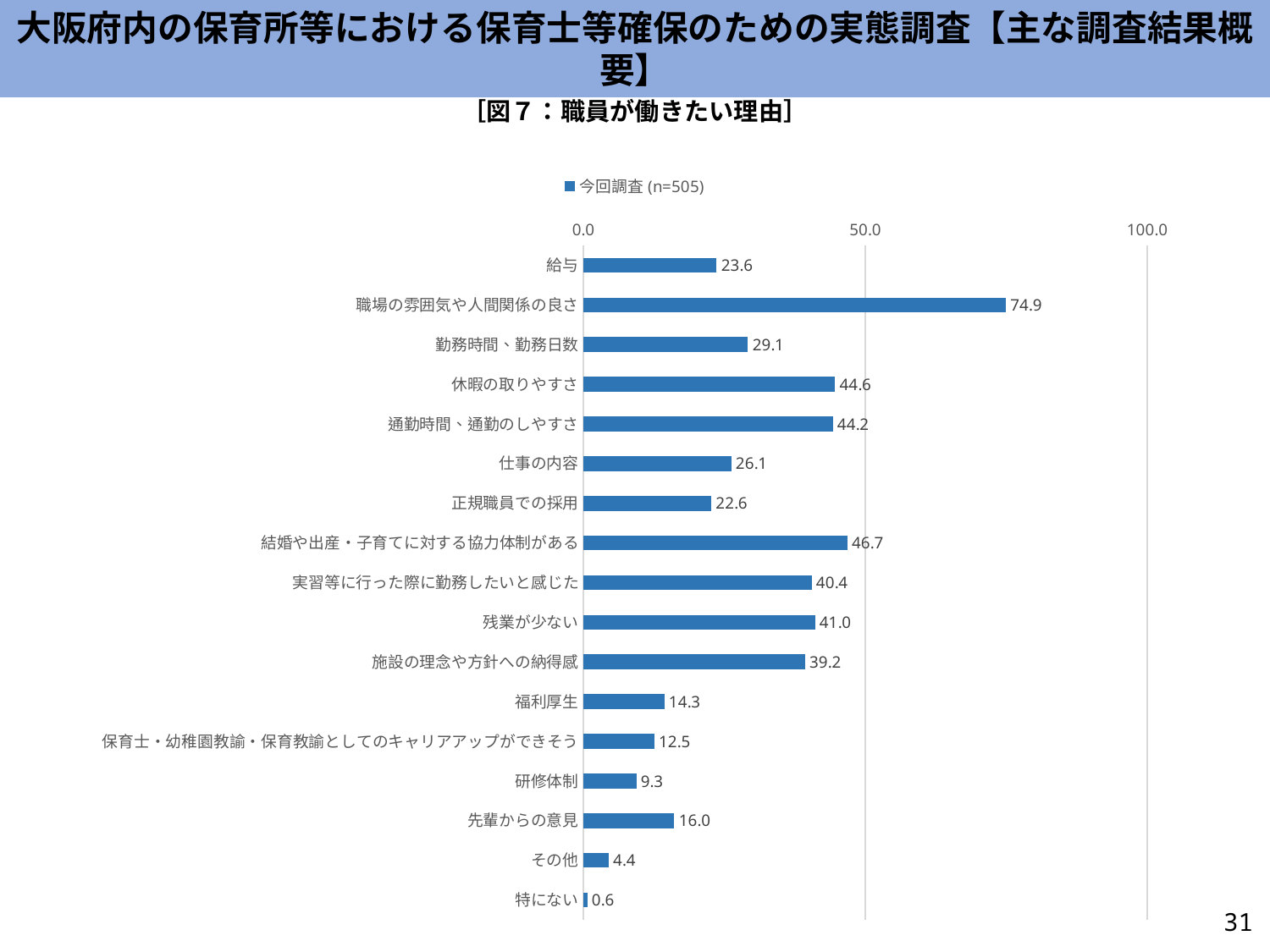
What kind of chart is shown on the slide? bar chart What is the value for 給与? 23.6 What is the value for 職場の雰囲気や人間関係の良さ? 74.9 How many series does the legend list? 1 How many categories are shown in the chart? 17 What is the value for 残業が少ない? 41.0 Which category has the lowest value? 特にない Which category has the highest value? 職場の雰囲気や人間関係の良さ Is the value for 結婚や出産・子育てに対する協力体制がある greater or less than 50.0? less What is the legend entry of the chart? 今回調査 (n=505) Which is larger, the value for 福利厚生 or the value for 先輩からの意見? 先輩からの意見 What is the difference between the values for 休暇の取りやすさ and 通勤時間、通勤のしやすさ? 0.4